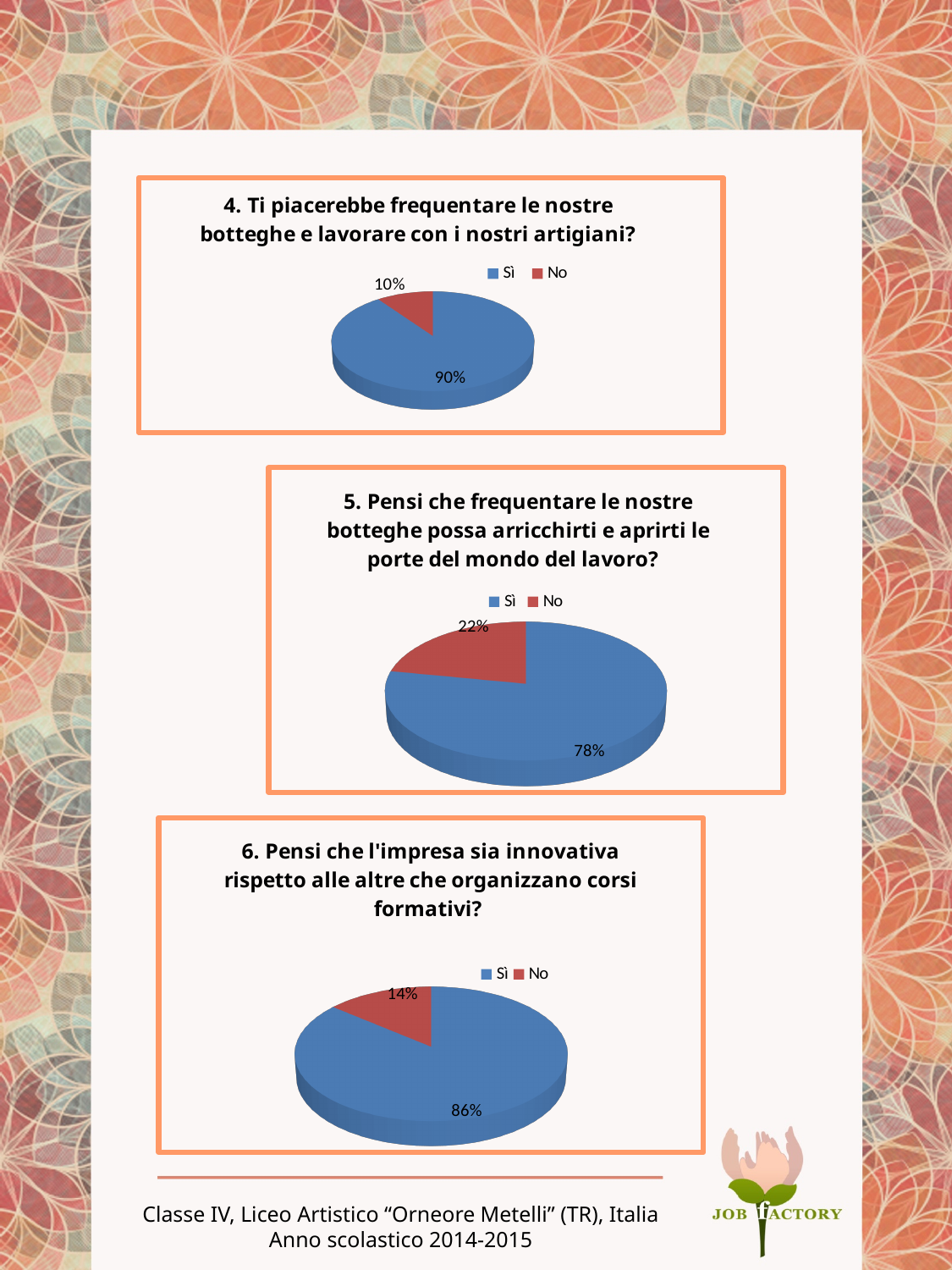
How many entries does the legend of the bottom chart (question 6) list? 2 In the top chart (question 4), what percentage answered No? 10% In the middle chart (question 5), what percentage answered No? 22% In the top chart (question 4), what percentage answered Sì? 90% In the middle chart (question 5), what is the difference between the Sì and No shares? 56% In the top chart (question 4), what colour is the Sì slice? Blue In the middle chart (question 5), what percentage answered Sì? 78% How many slices does the middle chart (question 5) have? 2 In the bottom chart (question 6), what percentage answered No? 14% In the bottom chart (question 6), which answer has the larger share, Sì or No? Sì What kind of chart is used in the top chart (question 4)? Pie chart In the bottom chart (question 6), what percentage answered Sì? 86%